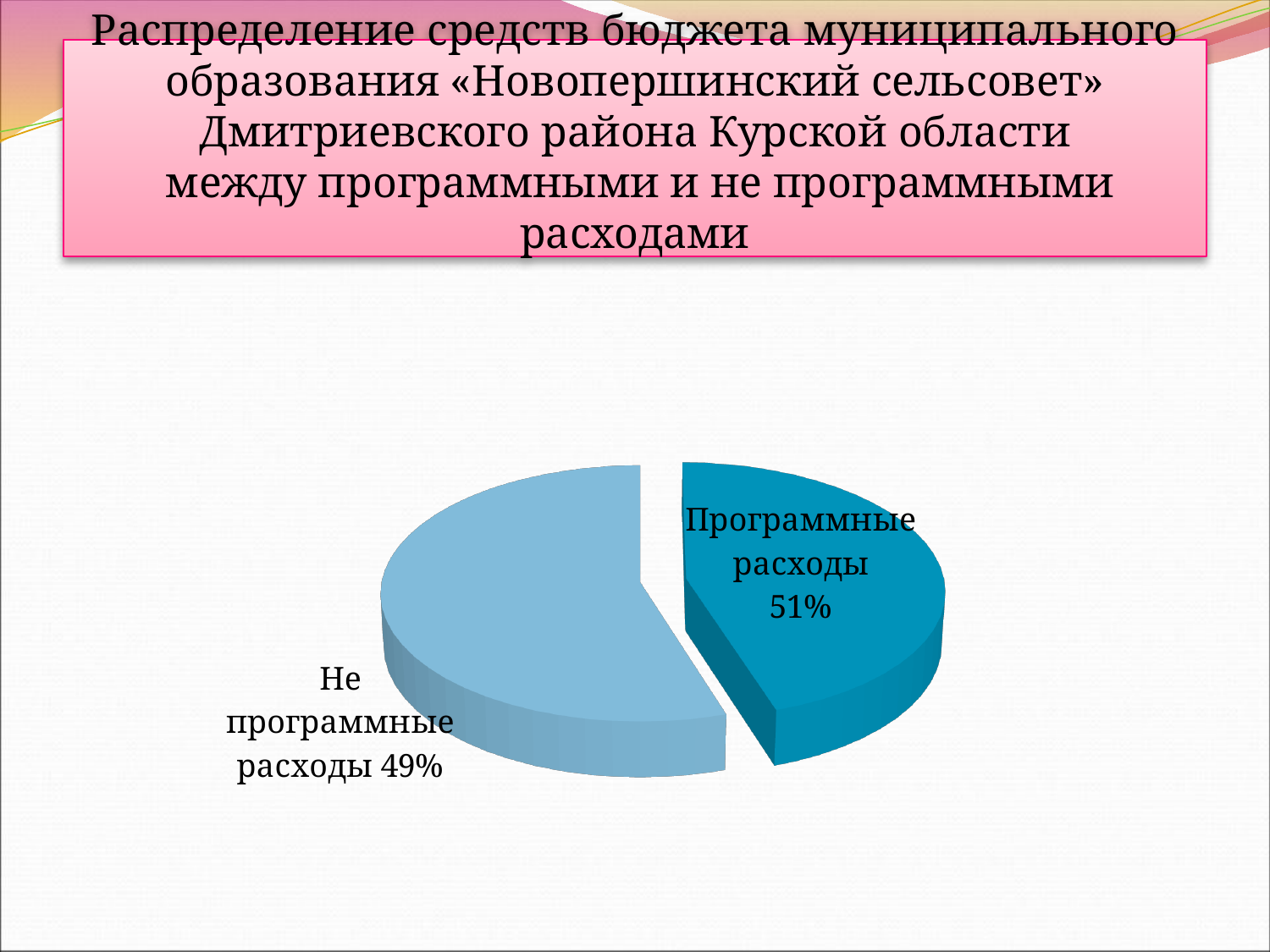
What is the total of the two slice percentages shown? 100% What share of the pie is labelled "Не программные расходы"? 49% Which slice is pulled out (exploded) from the rest of the pie? Программные расходы Which slice is drawn in the darker blue colour? Программные расходы What kind of chart is shown on the slide? Pie chart How many slices does the pie chart have? 2 What share of the pie is labelled "Программные расходы"? 51% What is the difference in percentage points between the "Программные расходы" and "Не программные расходы" slices? 2%